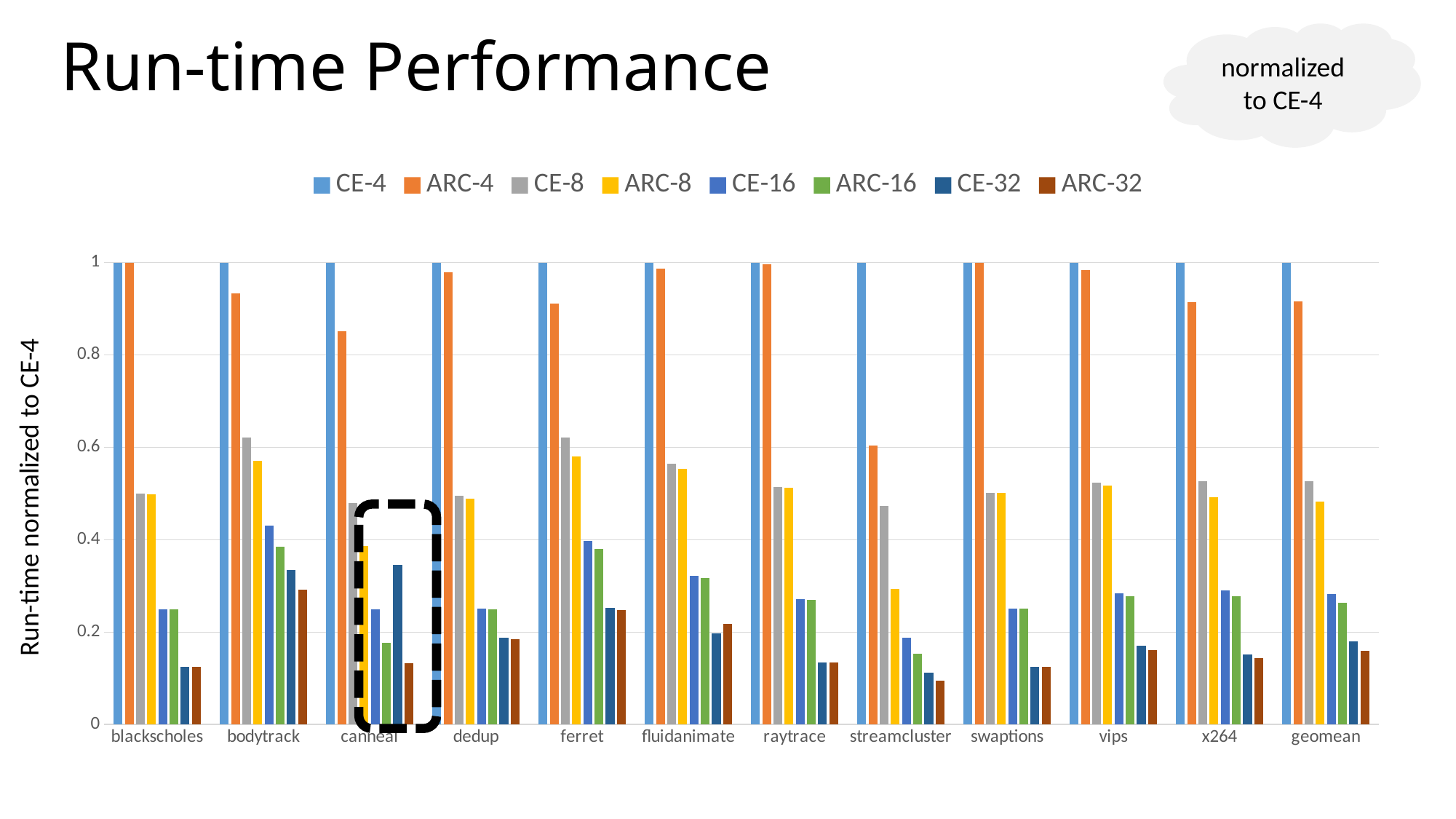
What kind of chart is shown on the slide? bar chart What is the title of the y axis? Run-time normalized to CE-4 Is the value of ARC-4 for canneal greater or less than 0.6? greater Which category has the lowest ARC-4 value? streamcluster Is the value of ARC-8 for geomean greater or less than 0.4? greater How many series does the legend list? 8 Is the value of ARC-4 for streamcluster greater or less than 0.8? less What is the value of CE-4 for blackscholes? 1 Which category has the lowest ARC-32 value? streamcluster Which is larger, the CE-16 value for bodytrack or the CE-16 value for blackscholes? bodytrack Within the canneal group, which is larger, the CE-32 bar or the ARC-16 bar? CE-32 How many categories are shown along the x axis? 12